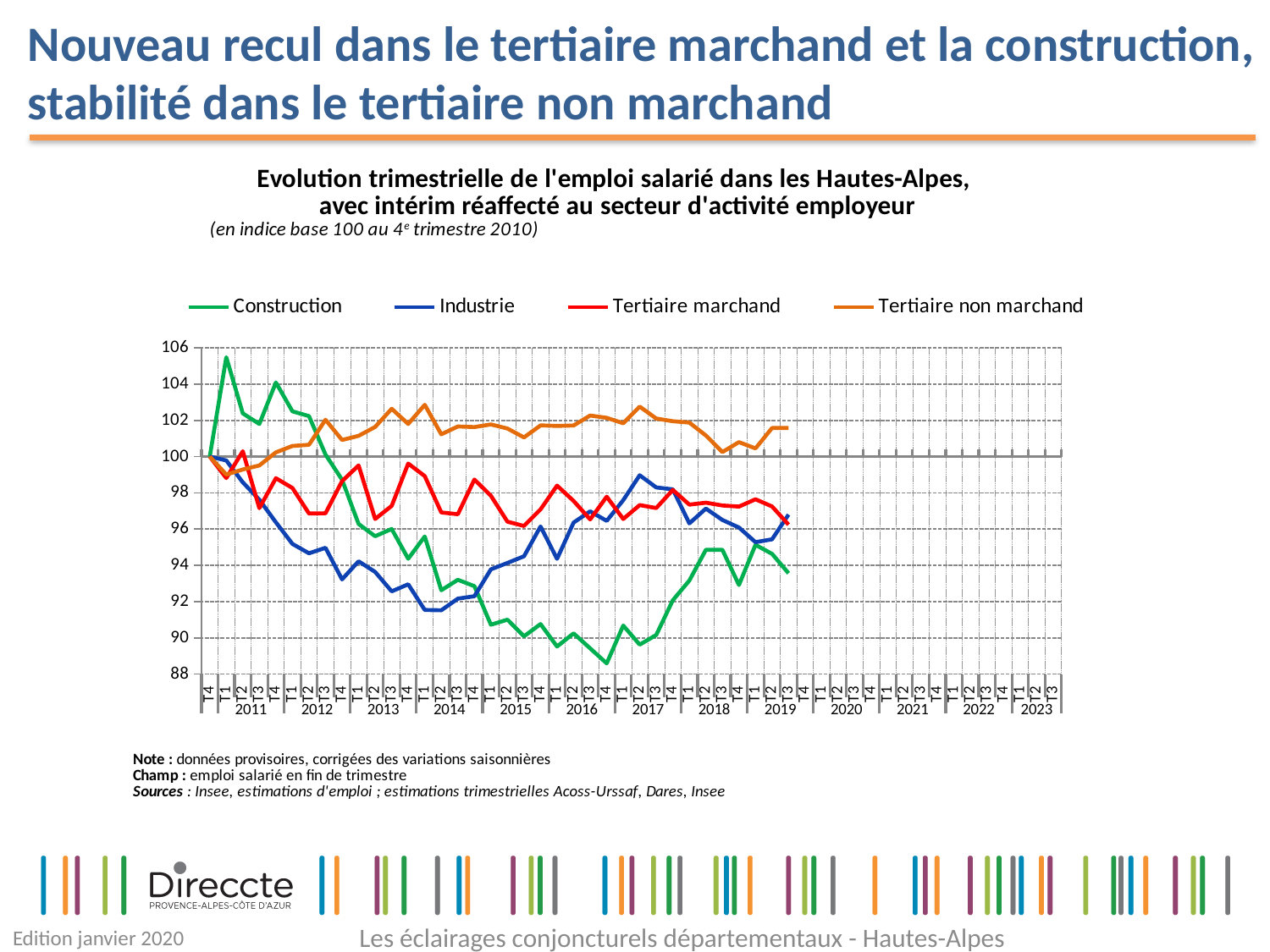
Is the value for Industrie at T2 2014 greater or less than 94? less Which series has the lowest value at T3 2019? Construction Which series has the highest value at T3 2019? Tertiaire non marchand What is the value of the Industrie series at T4 2010? 100 What colour is the Tertiaire marchand line? red At T3 2019, which series is higher, Construction or Industrie? Industrie Is the value for Construction at T4 2016 greater or less than 90? less Does the Construction series rise or fall between T1 2011 and T4 2016? fall What kind of chart is shown on the slide? line chart How many series does the legend list? 4 Is the value for Tertiaire non marchand at T2 2017 greater or less than 102? greater